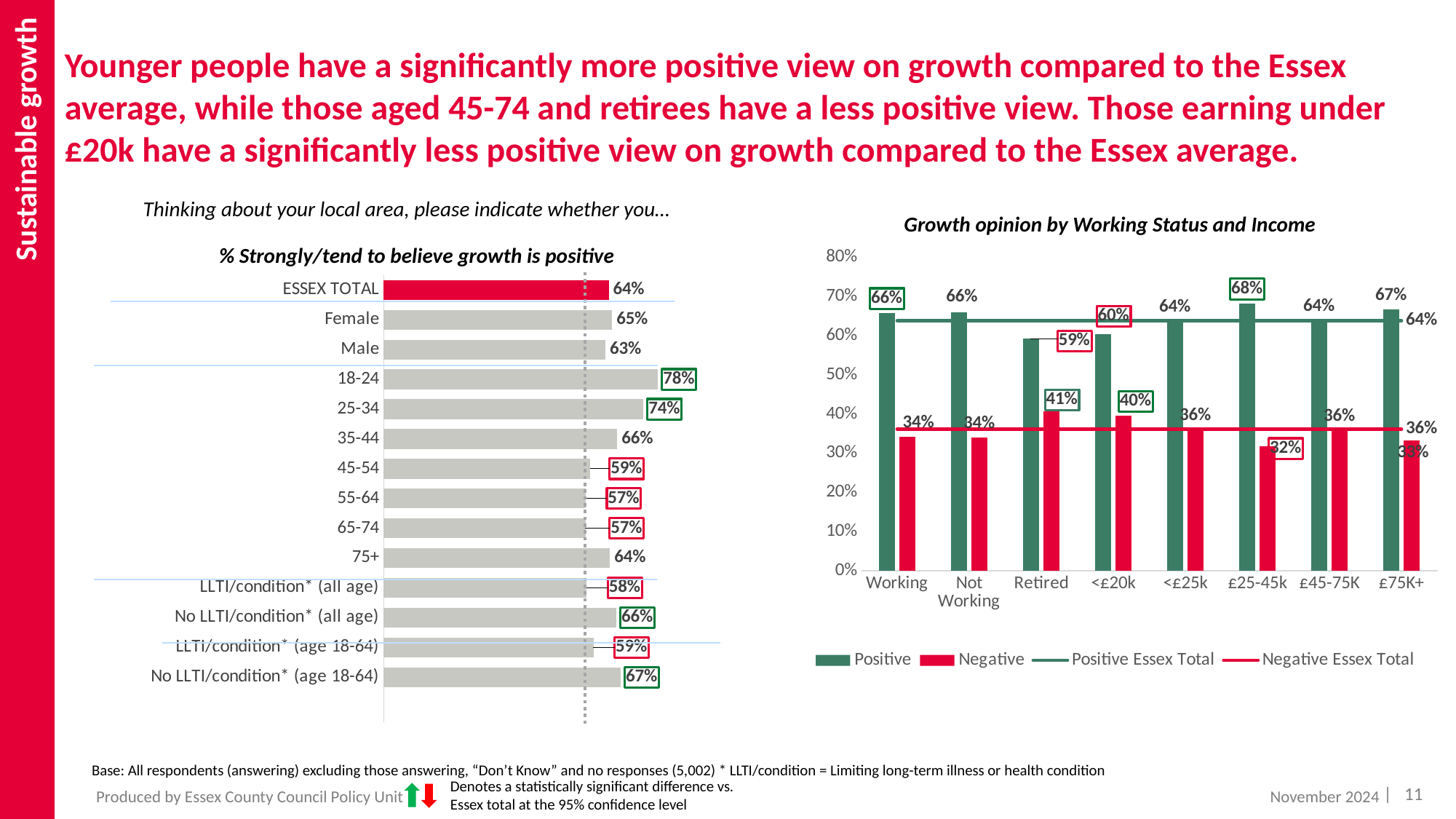
In the 'Growth opinion by Working Status and Income' chart, what is the Positive value for Retired? 59% In the '% Strongly/tend to believe growth is positive' chart, what kind of chart is it? Bar chart In the 'Growth opinion by Working Status and Income' chart, how many entries does the legend list? 4 In the '% Strongly/tend to believe growth is positive' chart, what is the value for ESSEX TOTAL? 64% In the 'Growth opinion by Working Status and Income' chart, which category has the lowest Positive value? Retired In the '% Strongly/tend to believe growth is positive' chart, what is the value for 18-24? 78% In the 'Growth opinion by Working Status and Income' chart, which category has the highest Positive value? £25-45k In the '% Strongly/tend to believe growth is positive' chart, which is larger, the value for Female or the value for Male? Female In the 'Growth opinion by Working Status and Income' chart, what is the Negative value for £25-45k? 32% In the 'Growth opinion by Working Status and Income' chart, how many categories are shown on the x axis? 8 In the '% Strongly/tend to believe growth is positive' chart, which category has the highest value? 18-24 In the '% Strongly/tend to believe growth is positive' chart, what is the difference between the values for 18-24 and 65-74? 21%